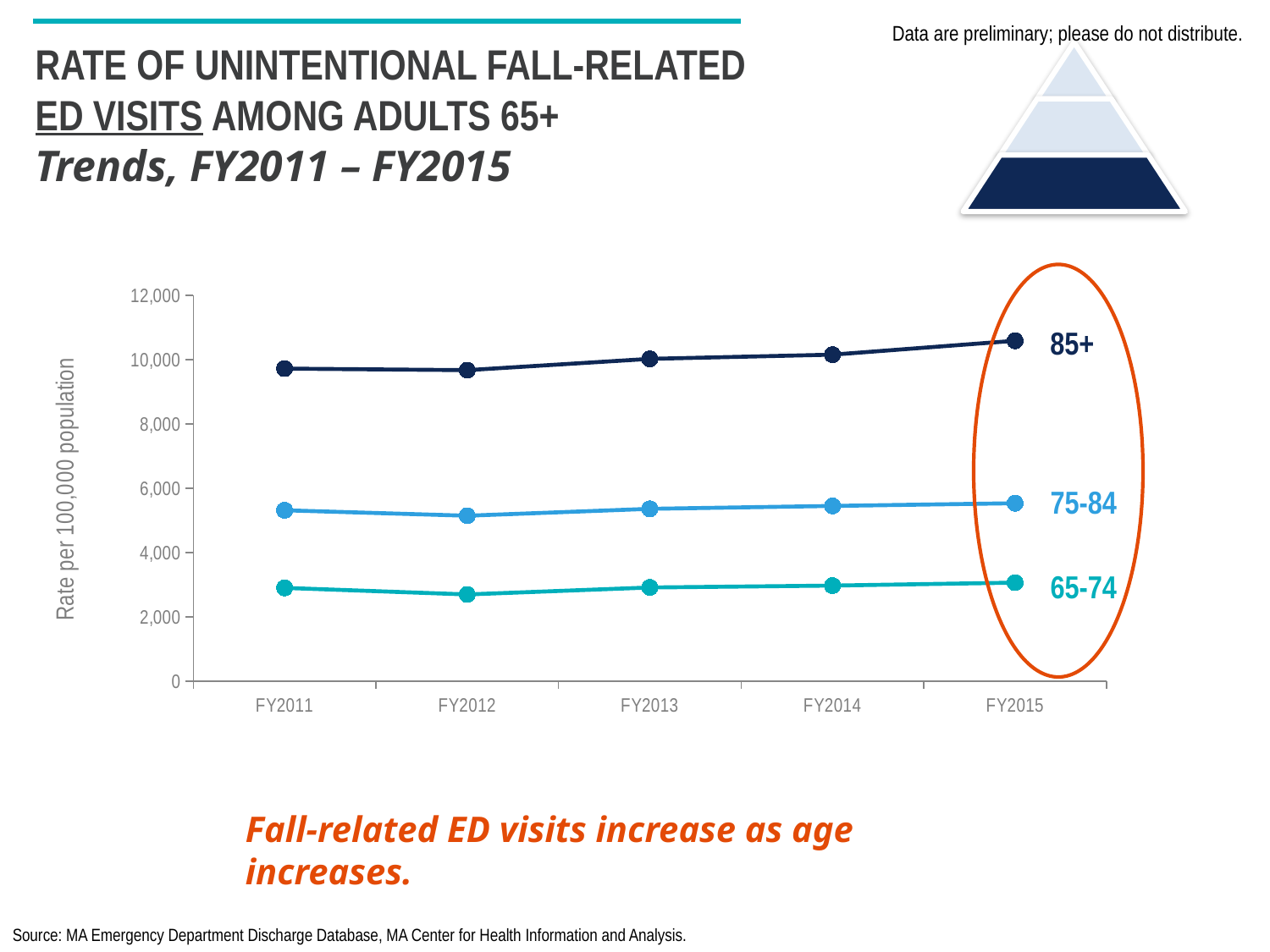
What kind of chart is shown on the slide? line chart How many fiscal years are shown along the x axis? 5 What is the label on the y axis of the chart? Rate per 100,000 population How many series (age groups) are plotted on the chart? 3 Which is larger in FY2014: the rate for the 75-84 group or the rate for the 65-74 group? 75-84 Is the value for the 85+ group in FY2015 greater or less than 10,000? greater Which age group is plotted with the darkest (navy) line? 85+ Is the value for the 65-74 group in FY2012 greater or less than 2,000? greater Is the value for the 75-84 group in FY2013 greater or less than 6,000? less Which age group has the highest rate of fall-related ED visits in FY2015? 85+ Does the rate for the 85+ group rise or fall from FY2011 to FY2015? rise Which age group has the lowest rate of fall-related ED visits in FY2015? 65-74